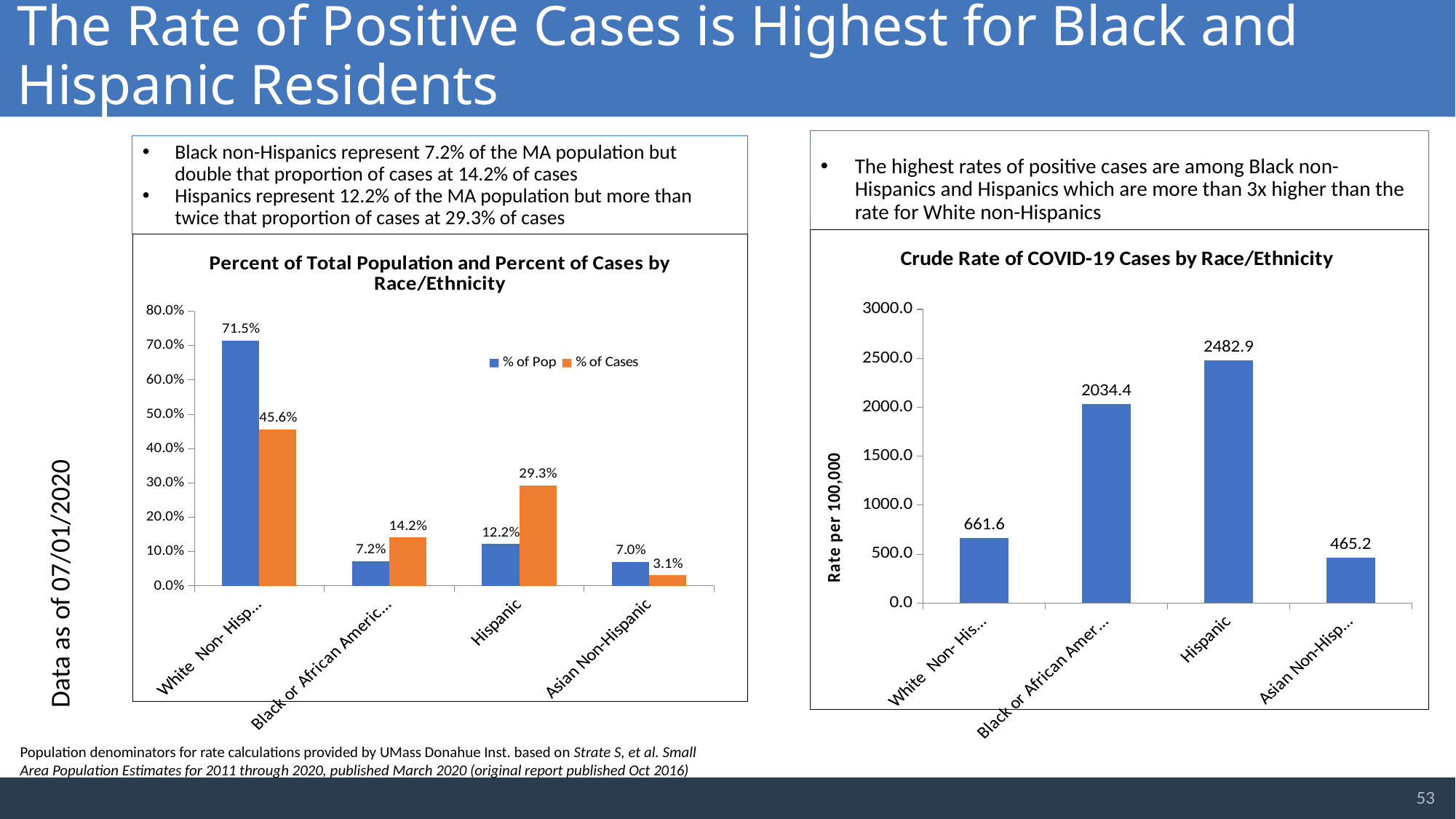
What kind of chart is the chart titled "Crude Rate of COVID-19 Cases by Race/Ethnicity"? Bar chart In the chart titled "Crude Rate of COVID-19 Cases by Race/Ethnicity", which category has the lowest rate? Asian Non-Hispanic In the chart titled "Crude Rate of COVID-19 Cases by Race/Ethnicity", how many categories are shown? 4 In the chart titled "Percent of Total Population and Percent of Cases by Race/Ethnicity", what is the difference between % of Cases and % of Pop for Hispanic? 17.1% In the chart titled "Percent of Total Population and Percent of Cases by Race/Ethnicity", which is larger for Hispanic: % of Pop or % of Cases? % of Cases In the chart titled "Crude Rate of COVID-19 Cases by Race/Ethnicity", what is the rate for Hispanic? 2482.9 In the chart titled "Crude Rate of COVID-19 Cases by Race/Ethnicity", which category has the highest rate? Hispanic In the chart titled "Crude Rate of COVID-19 Cases by Race/Ethnicity", what is the rate for Asian Non-Hispanic? 465.2 In the chart titled "Percent of Total Population and Percent of Cases by Race/Ethnicity", what is the % of Pop value for Asian Non-Hispanic? 7.0% In the chart titled "Percent of Total Population and Percent of Cases by Race/Ethnicity", how many series does the legend list? 2 In the chart titled "Crude Rate of COVID-19 Cases by Race/Ethnicity", what is the difference between the Hispanic rate and the Asian Non-Hispanic rate? 2017.7 In the chart titled "Percent of Total Population and Percent of Cases by Race/Ethnicity", what is the % of Cases value for Hispanic? 29.3%